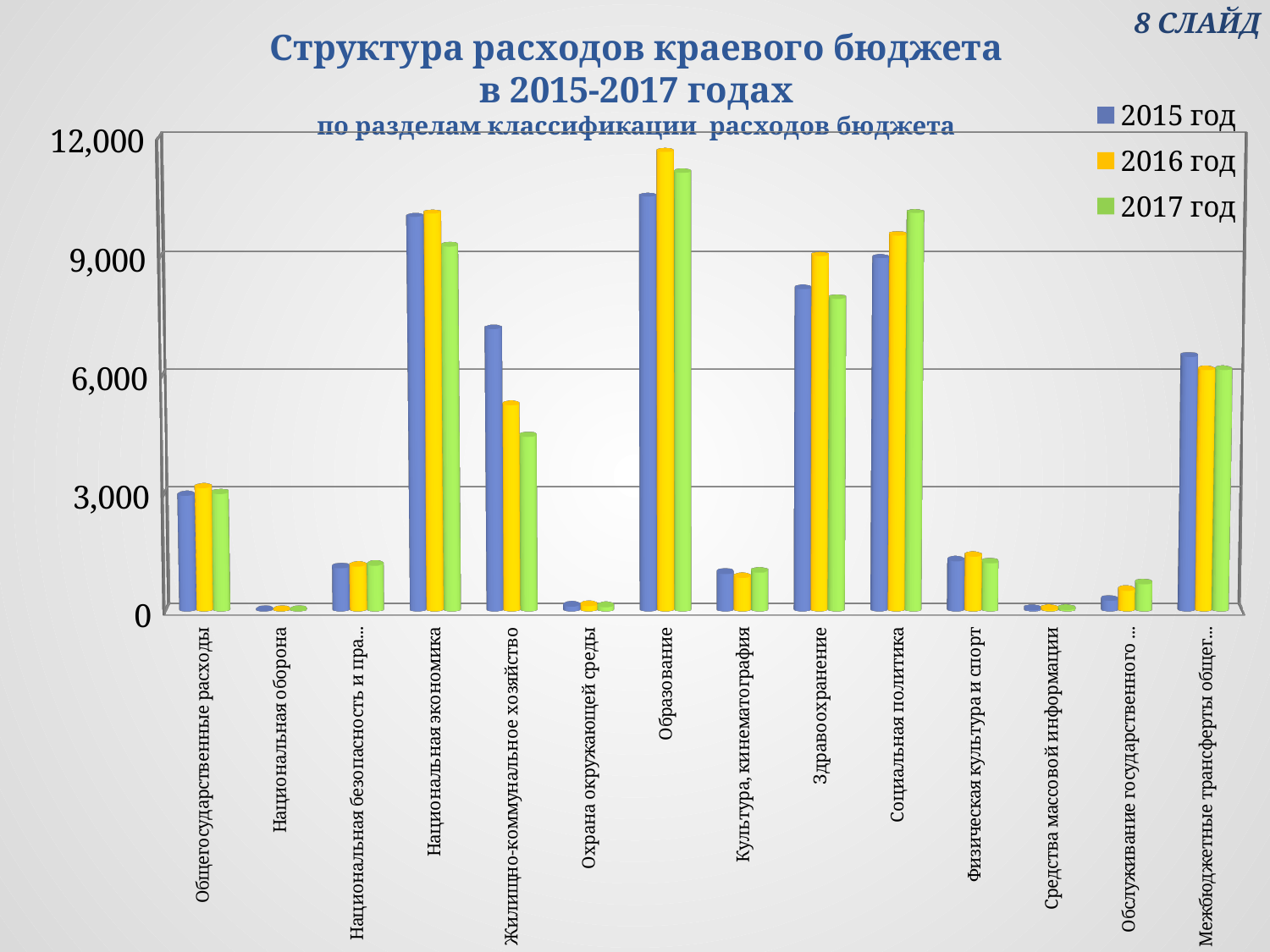
What kind of chart is shown on the slide? bar chart Is the value for Социальная политика in 2017 год greater or less than 9,000? greater How many series does the legend list? 3 How many budget categories are shown along the x axis? 14 Is the value for Образование in 2016 год greater or less than 9,000? greater Which is larger for 2016 год: Образование or Здравоохранение? Образование Which category has the highest value for 2015 год? Образование Do the values for Жилищно-коммунальное хозяйство rise or fall from 2015 год to 2017 год? fall Is the value for Жилищно-коммунальное хозяйство in 2017 год greater or less than 6,000? less Which colour represents 2016 год in the legend? yellow Which category has the highest value for 2016 год? Образование